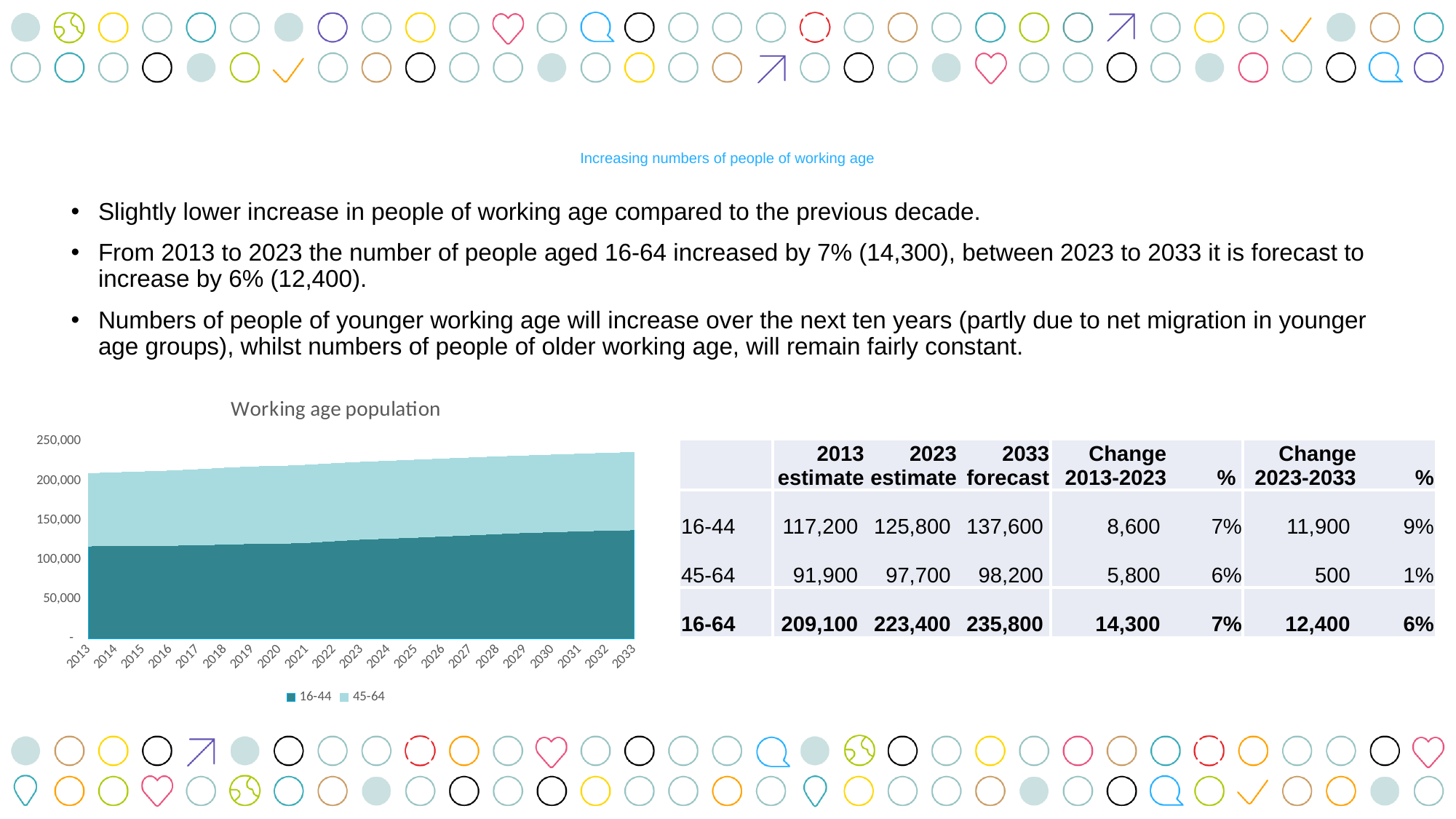
According to the table next to the "Working age population" chart, what is the total 16-64 population in the 2023 estimate? 223,400 According to the table next to the "Working age population" chart, what is the 2033 forecast for the 16-44 group? 137,600 Does the total working age population in the "Working age population" chart rise or fall from 2013 to 2033? Rise Which two series are shown in the legend of the "Working age population" chart? 16-44 and 45-64 In the "Working age population" chart, which series is larger in 2023, 16-44 or 45-64? 16-44 How many series does the legend of the "Working age population" chart list? 2 In the "Working age population" chart, is the value for the 16-44 series in 2033 greater or less than 150,000? less What is the first year on the x axis of the "Working age population" chart? 2013 In the "Working age population" chart, is the value for the 16-44 series in 2013 greater or less than 100,000? greater In the "Working age population" chart, is the total stacked value in 2033 greater or less than 200,000? greater What kind of chart is the "Working age population" chart? Stacked area chart How many years are shown on the x axis of the "Working age population" chart? 21